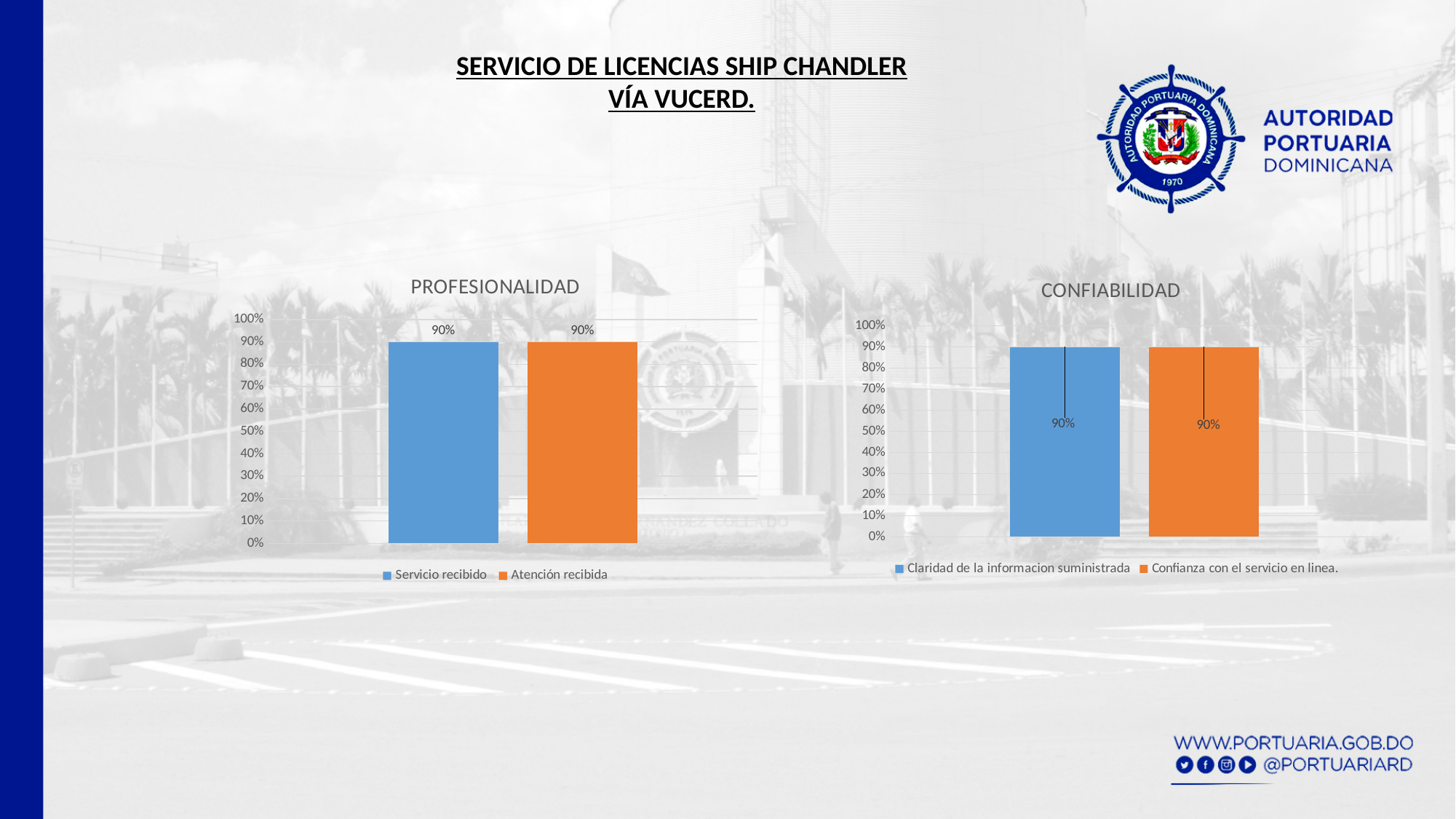
In the PROFESIONALIDAD chart, what is the value for Servicio recibido? 90% In the CONFIABILIDAD chart, what is the difference between Claridad de la informacion suministrada and Confianza con el servicio en linea.? 0% In the CONFIABILIDAD chart, is the value for Confianza con el servicio en linea. greater or less than 100%? less How many series does the legend of the PROFESIONALIDAD chart list? 2 In the PROFESIONALIDAD chart, what is the difference between Servicio recibido and Atención recibida? 0% What is the title of the chart on the left side of the slide? PROFESIONALIDAD In the PROFESIONALIDAD chart, what is the value for Atención recibida? 90% What kind of chart is the CONFIABILIDAD chart? Bar chart How many series does the legend of the CONFIABILIDAD chart list? 2 In the PROFESIONALIDAD chart, is the value for Servicio recibido greater or less than 50%? greater In the CONFIABILIDAD chart, what is the value for Confianza con el servicio en linea.? 90% In the CONFIABILIDAD chart, what is the value for Claridad de la informacion suministrada? 90%